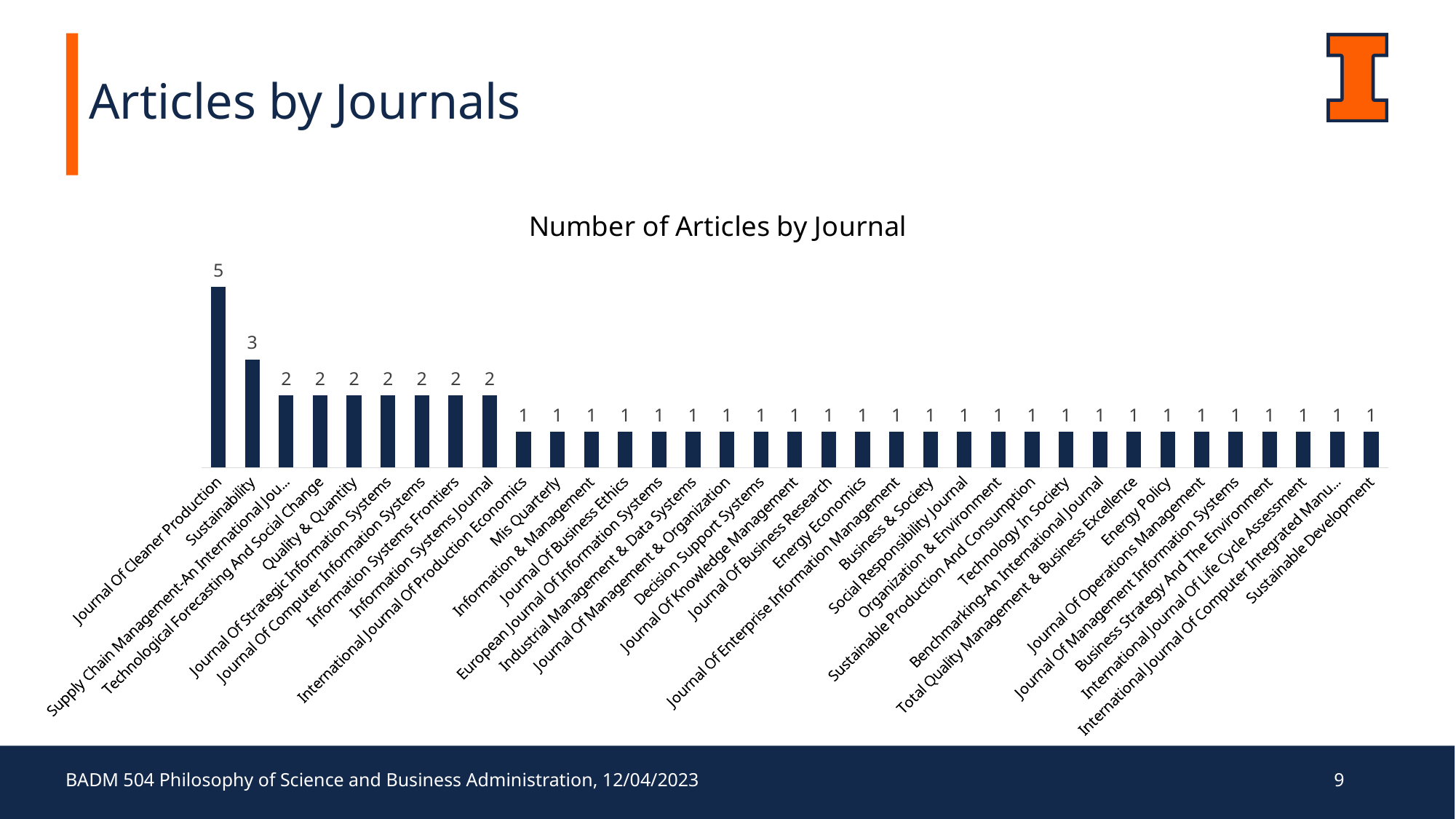
How many articles are from Sustainability? 3 What is the difference in number of articles between Journal Of Cleaner Production and Sustainability? 2 What is the title of the chart? Number of Articles by Journal Which journal has the highest number of articles? Journal Of Cleaner Production What kind of chart is shown on the slide? bar chart How many articles are from Quality & Quantity? 2 How many articles are from Journal Of Cleaner Production? 5 How many journals have exactly 2 articles? 7 How many journals are shown in the chart? 35 Do the values generally rise or fall from left to right along the x axis? fall How many articles are from Mis Quarterly? 1 Which has more articles, Information Systems Frontiers or Energy Policy? Information Systems Frontiers